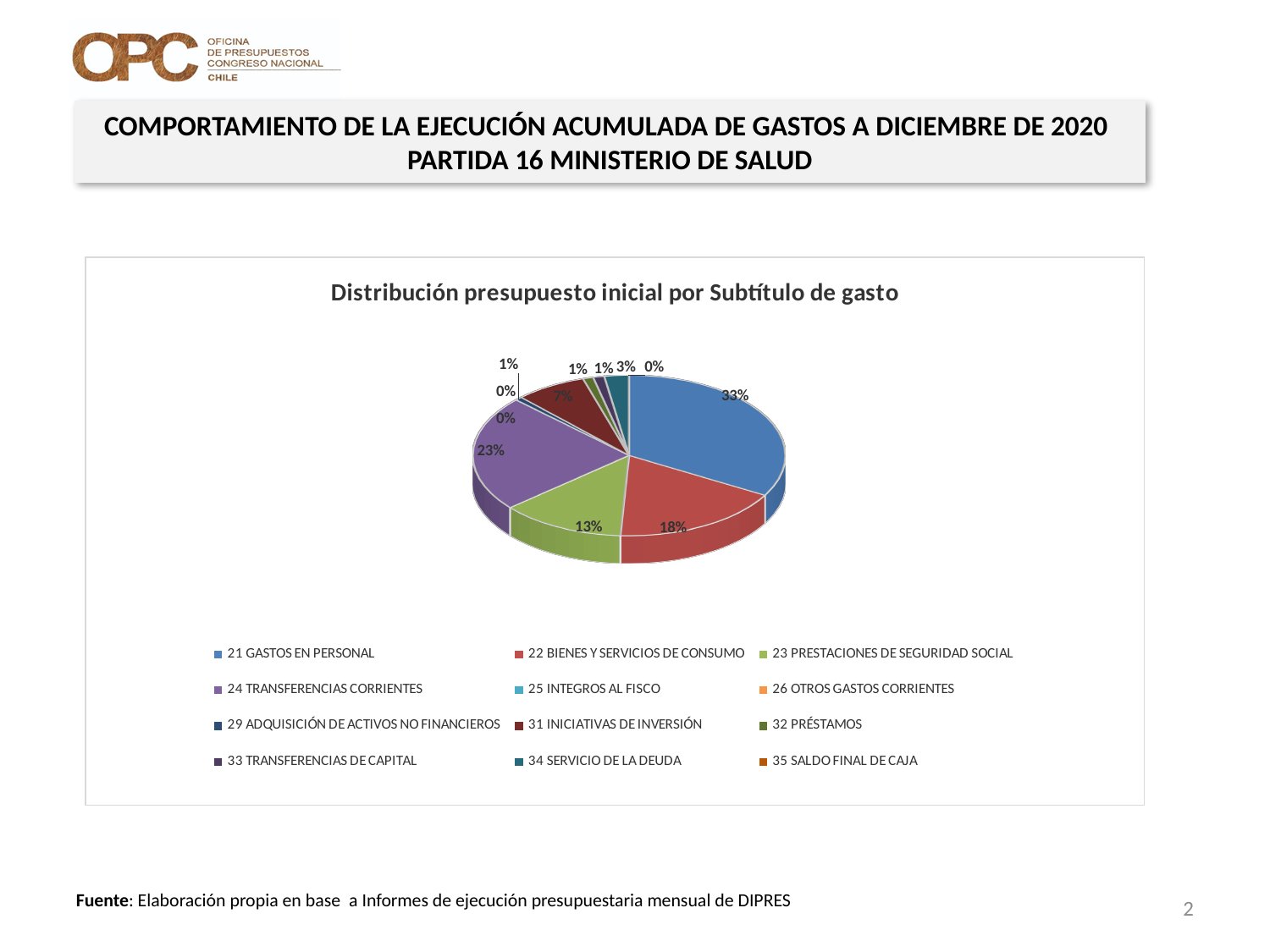
Which is larger: the share for 24 TRANSFERENCIAS CORRIENTES or for 22 BIENES Y SERVICIOS DE CONSUMO? 24 TRANSFERENCIAS CORRIENTES What share of the pie does 22 BIENES Y SERVICIOS DE CONSUMO represent? 18% What is the difference in percentage points between the shares of 21 GASTOS EN PERSONAL and 22 BIENES Y SERVICIOS DE CONSUMO? 15 percentage points What is the title of the chart? Distribución presupuesto inicial por Subtítulo de gasto Which category has the largest slice of the pie? 21 GASTOS EN PERSONAL How many categories does the chart's legend list? 12 What share of the pie does 24 TRANSFERENCIAS CORRIENTES represent? 23% What share of the pie does 31 INICIATIVAS DE INVERSIÓN represent? 7% Which category is shown in blue in the legend as the first entry? 21 GASTOS EN PERSONAL What kind of chart is shown on the slide? pie chart